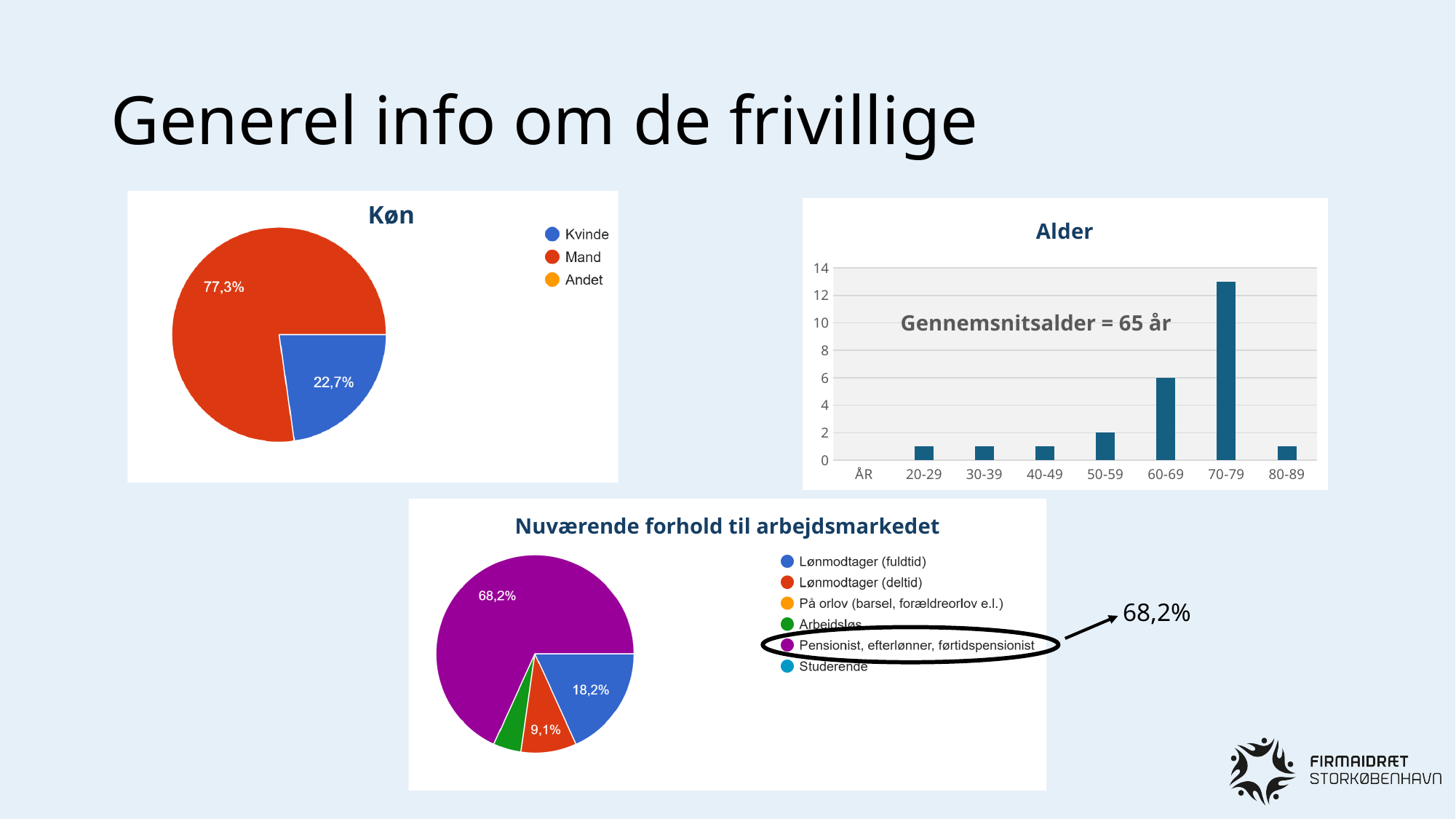
In the 'Alder' chart, which age group has the highest bar? 70-79 In the 'Køn' pie chart, how many entries does the legend list? 3 In the 'Alder' chart, is the value for 70-79 greater or less than 12? greater In the 'Nuværende forhold til arbejdsmarkedet' pie chart, what share is labelled for Lønmodtager (fuldtid)? 18,2% What kind of chart is the 'Alder' chart? Bar chart In the 'Køn' pie chart, what share is labelled for Kvinde? 22,7% In the 'Køn' chart, what is the difference between the Mand share and the Kvinde share? 54,6 percentage points In the 'Køn' pie chart, which is larger, the Mand slice or the Kvinde slice? Mand In the 'Alder' chart, what average age is stated in the text inside the plot area? 65 år In the 'Alder' chart, what is the value for the 60-69 age group? 6 In the 'Køn' pie chart, what share is labelled for Mand? 77,3% In the 'Alder' chart, what is the value for the 50-59 age group? 2